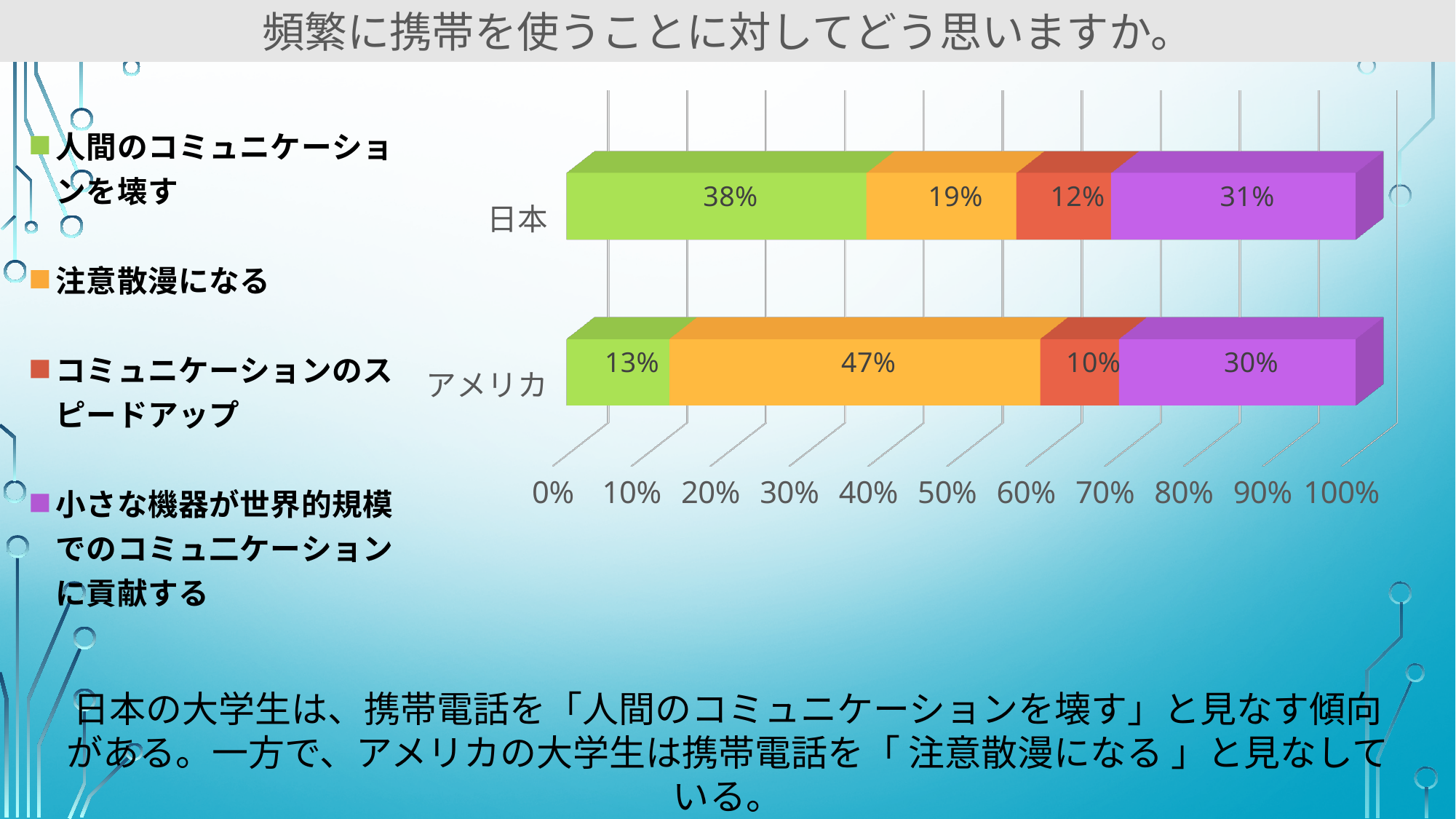
How many categories (countries) are shown on the chart? 2 What is the value for コミュニケーションのスピードアップ in the 日本 bar? 12% What is the value for 小さな機器が世界的規模でのコミュニケーションに貢献する in the アメリカ bar? 30% Which response has the smallest share in the アメリカ bar? コミュニケーションのスピードアップ Which is larger: the 人間のコミュニケーションを壊す value for 日本 or for アメリカ? 日本 What is the difference between the 注意散漫になる values for アメリカ and 日本? 28% What percentage of 日本 respondents chose 人間のコミュニケーションを壊す? 38% What kind of chart is shown on the slide? Stacked bar chart What is the total of the 日本 stacked bar? 100% What percentage of アメリカ respondents chose 注意散漫になる? 47% How many series does the legend list? 4 Which response has the largest share in the 日本 bar? 人間のコミュニケーションを壊す